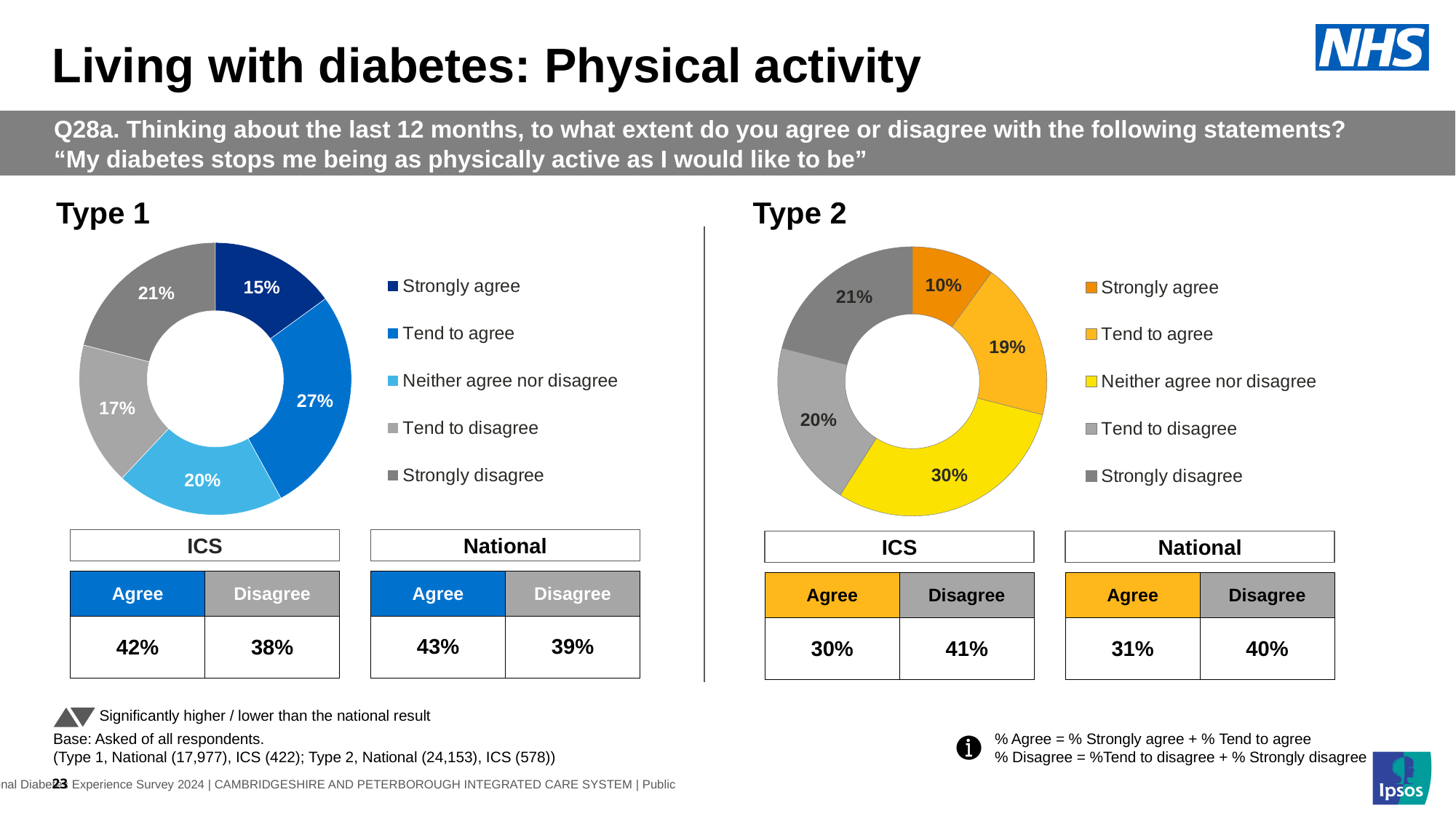
In the Type 2 chart, which response category has the smallest share? Strongly agree In the Type 2 chart, what is the value for 'Strongly agree'? 10% In the Type 2 chart, what is the difference in percentage points between 'Neither agree nor disagree' and 'Tend to agree'? 11 percentage points In the Type 1 chart, what is the value for 'Strongly disagree'? 21% What kind of chart is used for Type 1? Donut (pie) chart In the Type 1 chart, what percentage of respondents said 'Tend to agree'? 27% How many entries does the legend of the Type 1 chart list? 5 In the Type 2 chart, what percentage of respondents said 'Neither agree nor disagree'? 30% In the Type 1 chart, which is larger: 'Strongly disagree' or 'Tend to disagree'? Strongly disagree In the Type 1 chart, what is the difference in percentage points between 'Tend to agree' and 'Strongly agree'? 12 percentage points How many slices does the Type 2 chart have? 5 In the Type 1 chart, which response category has the largest share? Tend to agree